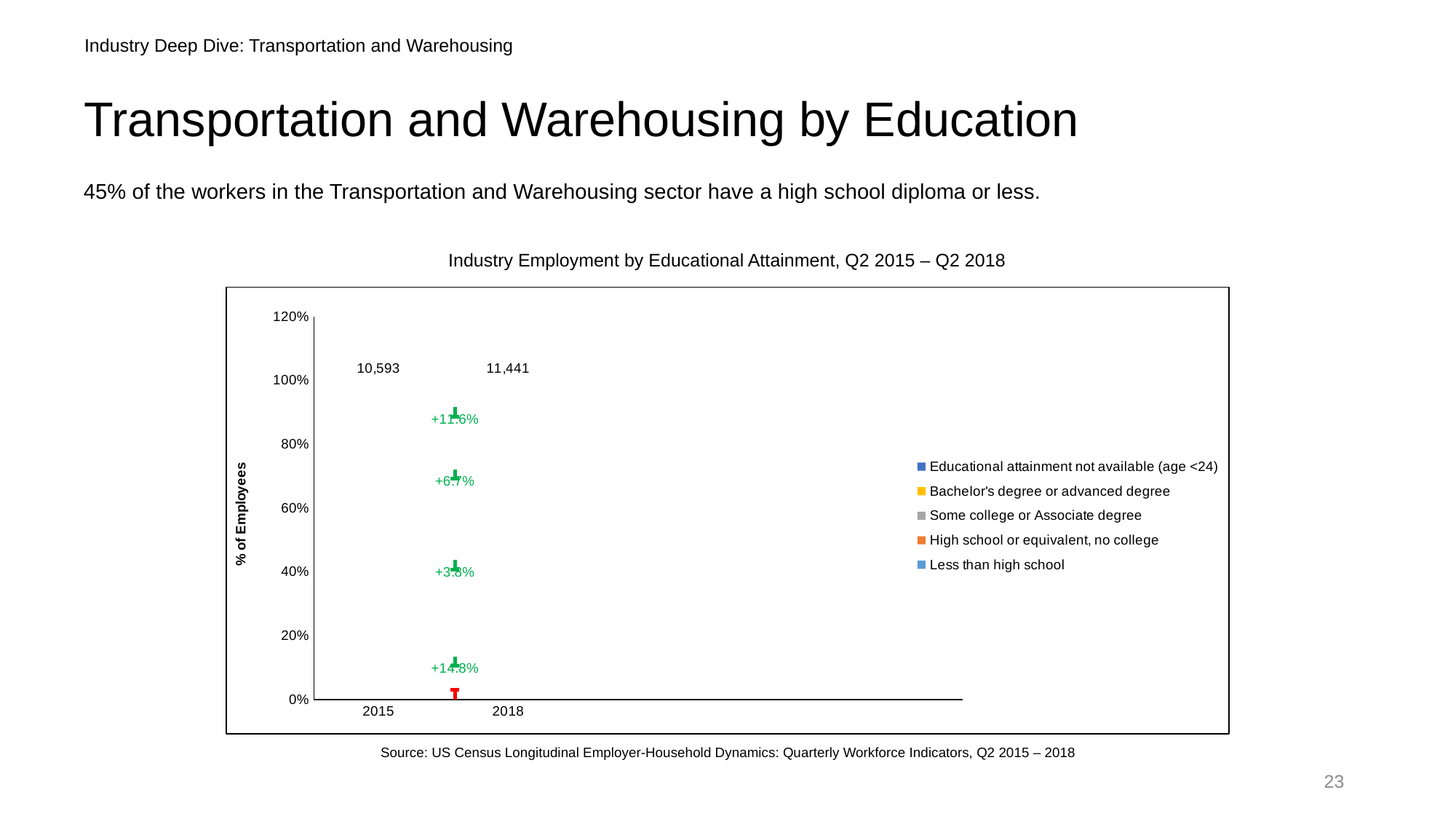
What total employment figure is printed above the 2015 bar? 10,593 What is the largest green percentage-change annotation shown between the 2015 and 2018 bars? +14.8% Which year has the larger total employment figure printed above its bar, 2015 or 2018? 2018 What is the smallest green percentage-change annotation shown between the 2015 and 2018 bars? +3.8% What is the label on the vertical axis of the chart? % of Employees How many years (categories) are shown on the x axis of the chart? 2 What total employment figure is printed above the 2018 bar? 11,441 How many series does the chart's legend list? 5 What is the title of the chart? Industry Employment by Educational Attainment, Q2 2015 – Q2 2018 By how much does the total printed for 2018 exceed the total printed for 2015? 848